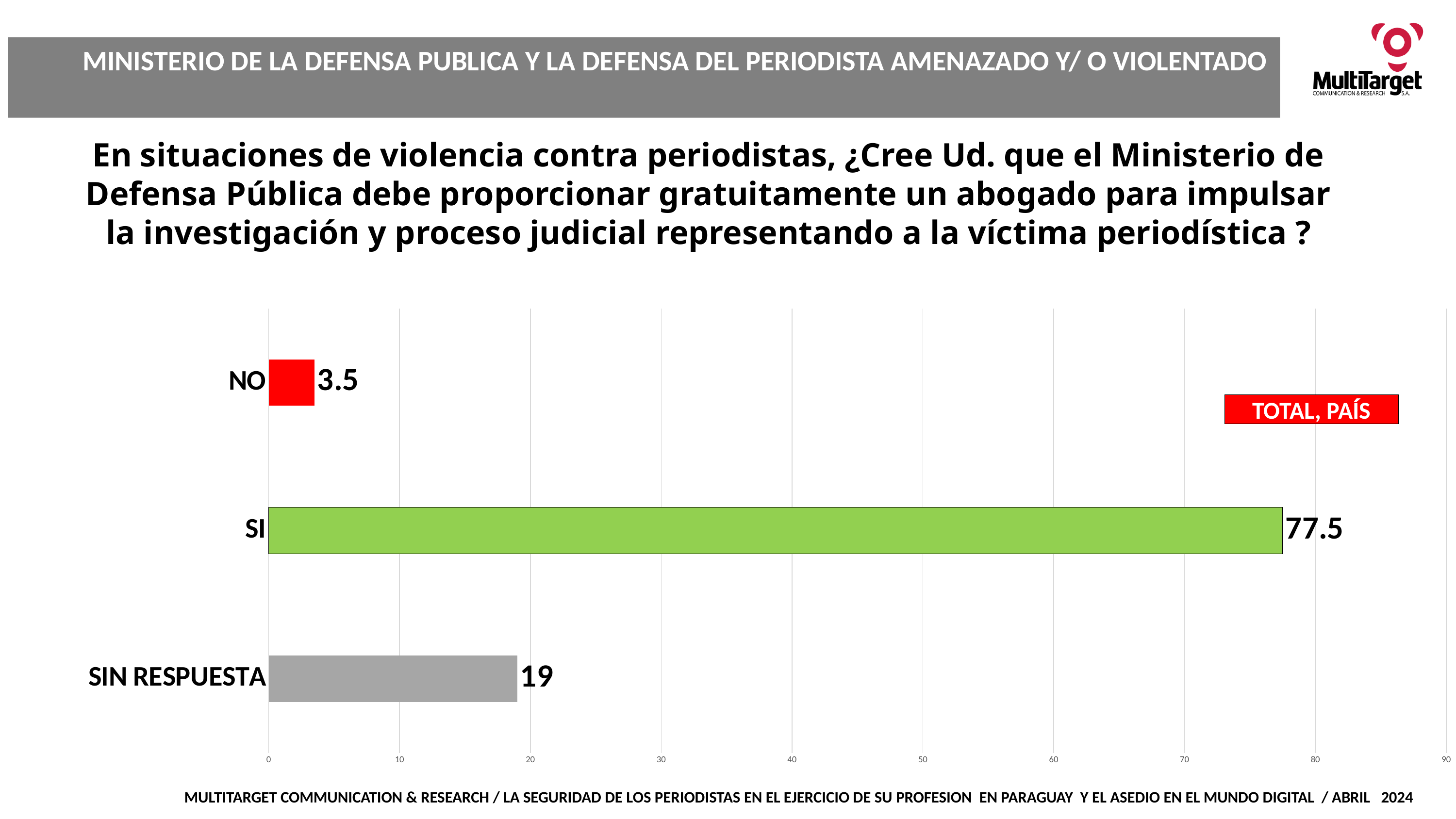
What is the value for SI? 77.5 What kind of chart is shown on the slide? bar chart Is the value for SI greater or less than 70? greater Which category has the lowest value? NO Which is larger, the value for SIN RESPUESTA or the value for NO? SIN RESPUESTA What is the value for SIN RESPUESTA? 19 How many categories are shown in the chart? 3 Which category has the highest value? SI What is the value for NO? 3.5 What colour is the bar for SI? green What is the difference between the values for SIN RESPUESTA and NO? 15.5 What is the difference between the values for SI and SIN RESPUESTA? 58.5